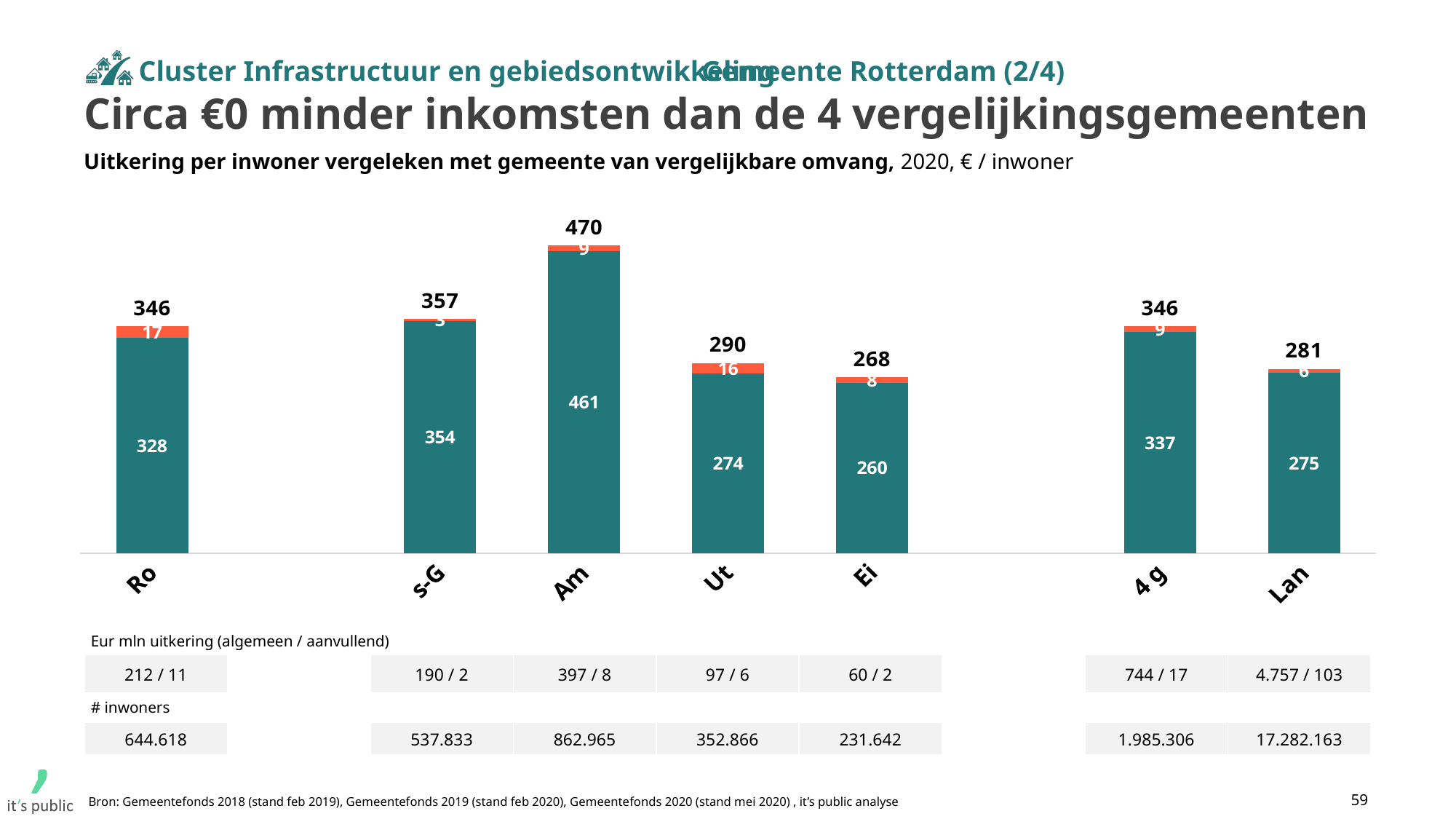
What is the total value shown above the bar for Am? 470 Which has a larger total, s-G or Lan? s-G What kind of chart is shown on the slide? Stacked bar chart How many bars are shown in the chart? 7 What unit is stated in the chart subtitle for the values? € / inwoner What is the value of the teal (lower) segment for Ro? 328 What is the value of the teal (lower) segment for 4 g? 337 What is the difference between the totals for Am and Ei? 202 Which category has the highest total? Am Which category has the lowest total? Ei What is the value of the orange (upper) segment for Ut? 16 What is the total value shown above the bar for Lan? 281